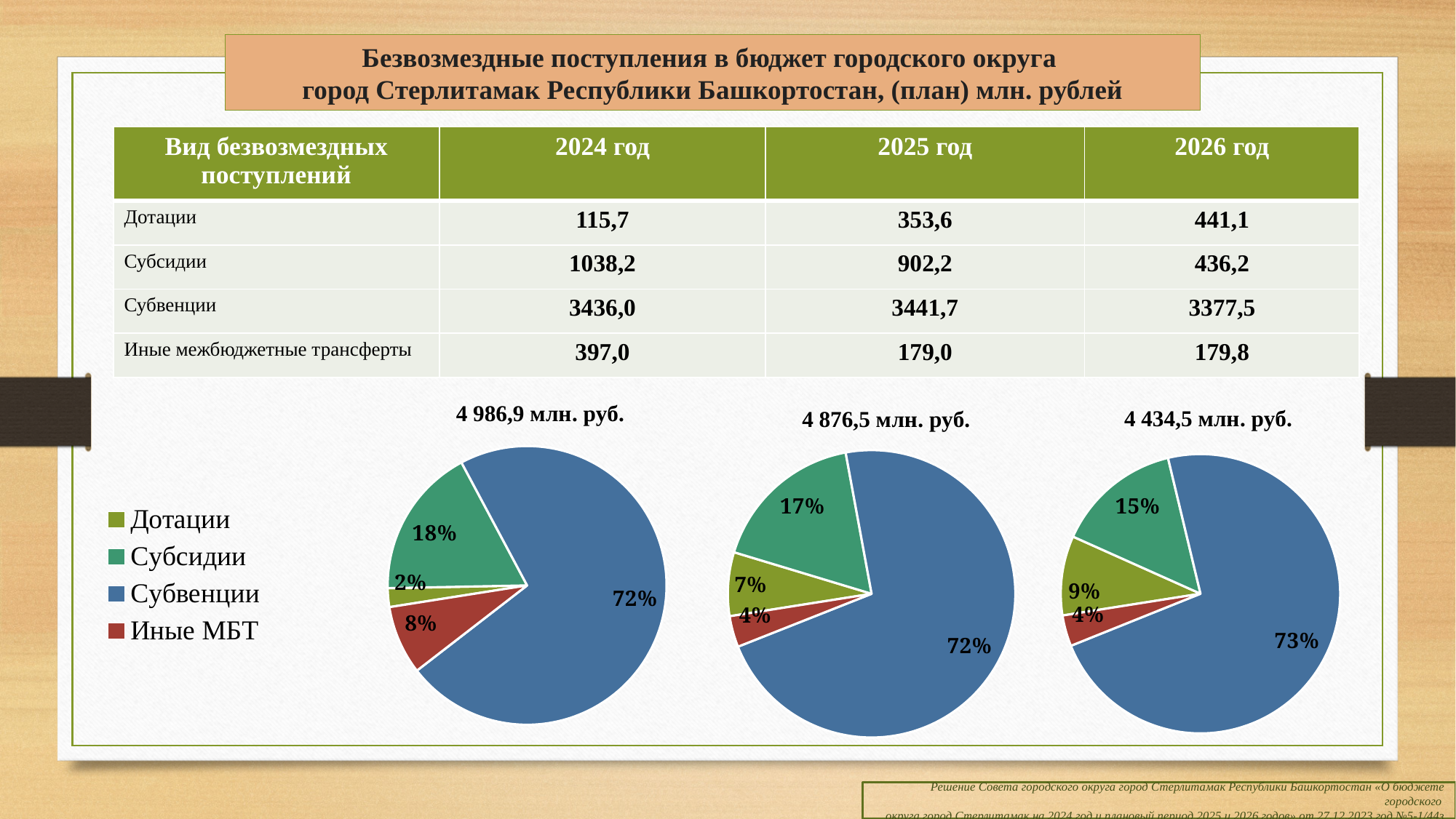
In the middle pie chart (4 876,5 млн. руб.), what share is labelled for Субсидии? 17% How many entries does the legend list for the pie charts? 4 In the left pie chart (4 986,9 млн. руб.), what share is labelled for Иные МБТ? 8% In the left pie chart (4 986,9 млн. руб.), what share is labelled for Субвенции? 72% In the left pie chart (4 986,9 млн. руб.), which category has the largest slice? Субвенции What total is printed above the middle pie chart? 4 876,5 млн. руб. What kind of charts are shown at the bottom of the slide? Pie charts How many pie charts are on the slide? 3 In the right pie chart (4 434,5 млн. руб.), which category has the smallest slice? Иные МБТ